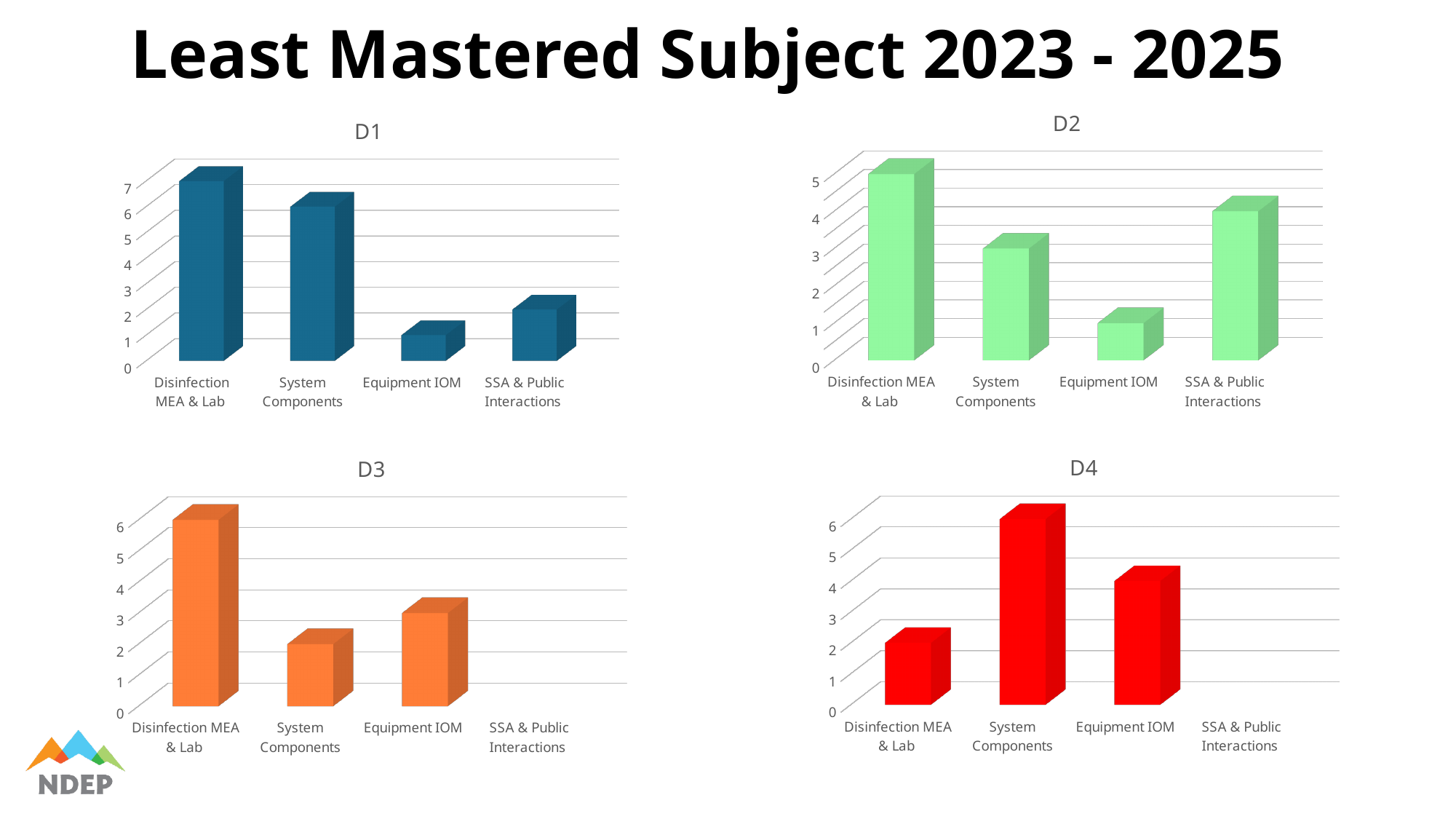
In the D4 chart, is the value for Disinfection MEA & Lab greater or less than 3? less In the D2 chart, is the value for SSA & Public Interactions greater or less than 2? greater In the D1 chart, which category has the lowest value? Equipment IOM In the D1 chart, what is the value for Disinfection MEA & Lab? 7 How many categories are shown on the x axis of the D3 chart? 4 What kind of chart is the D1 chart? bar chart In the D2 chart, which is larger, System Components or Equipment IOM? System Components In the D4 chart, which category has the highest value? System Components In the D3 chart, which category has the highest value? Disinfection MEA & Lab In the D1 chart, which category has the highest value? Disinfection MEA & Lab What colour are the bars in the D4 chart? red